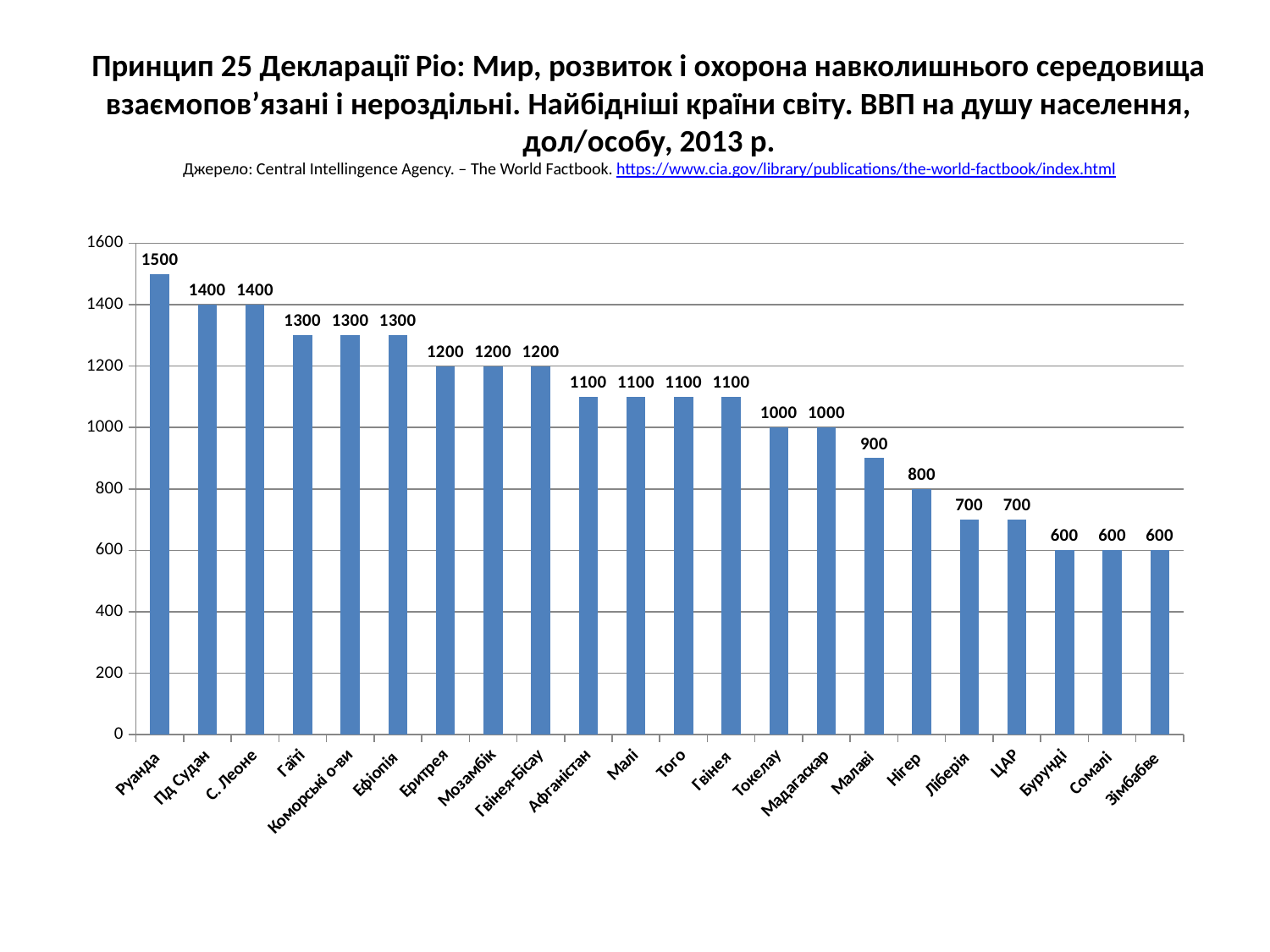
Do the values rise or fall from left to right along the x axis? fall Is the value for Ліберія greater or less than 800? less What kind of chart is this? bar chart What is the value for Малаві? 900 What is the value for Афганістан? 1100 What is the value for Нігер? 800 How many countries are shown on the chart? 22 What is the value for Руанда? 1500 Which country has the highest value? Руанда What is the difference between the values for Руанда and Зімбабве? 900 Which is larger, the value for Гаїті or the value for Токелау? Гаїті What is the lowest value shown on the chart? 600